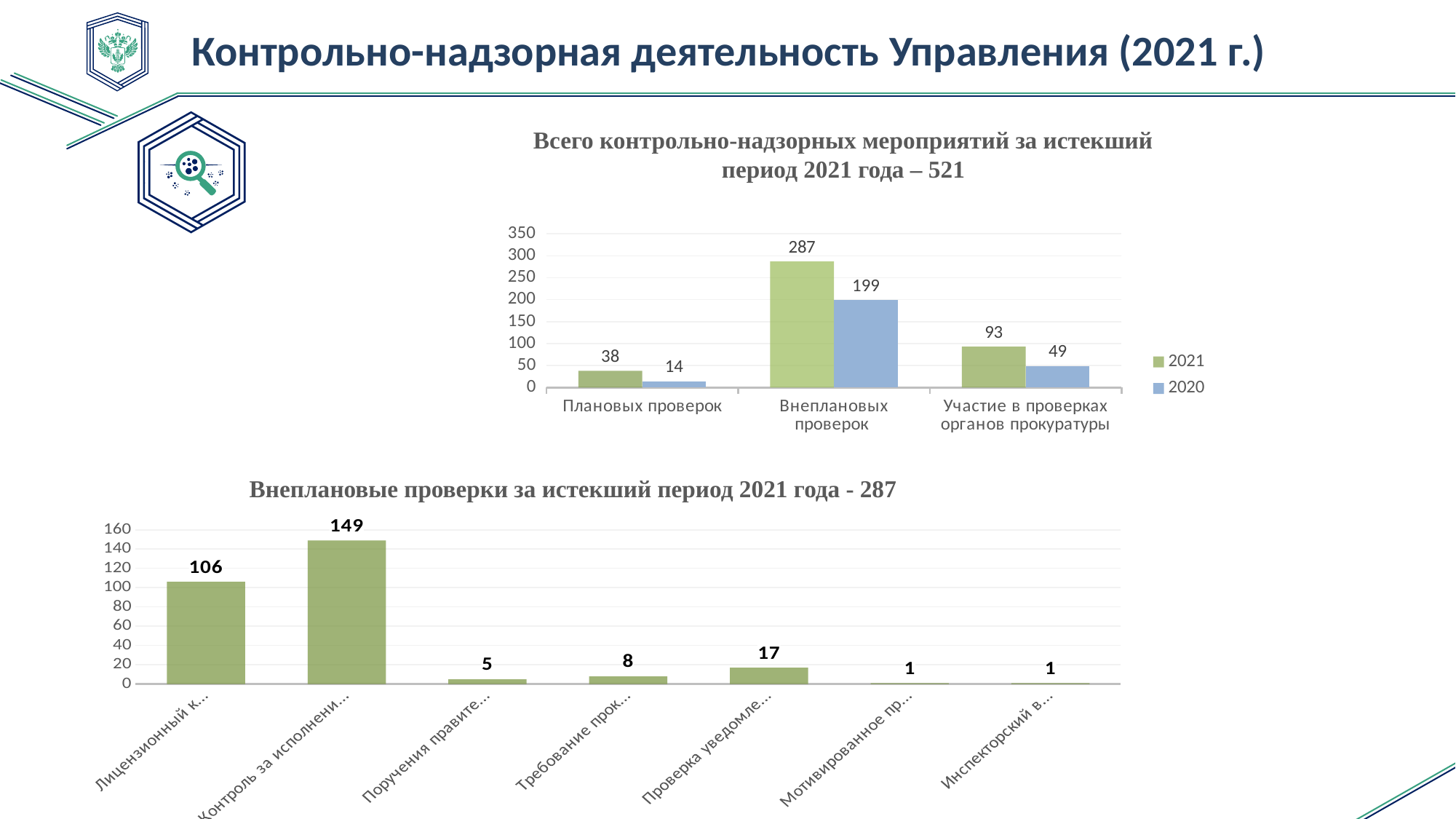
In the bottom chart (Внеплановые проверки за истекший период 2021 года), how many categories are plotted? 7 What kind of chart is the bottom chart (Внеплановые проверки за истекший период 2021 года)? Bar chart In the top chart (Всего контрольно-надзорных мероприятий), what is the 2021 value for Внеплановых проверок? 287 In the top chart (Всего контрольно-надзорных мероприятий), what is the 2020 value for Участие в проверках органов прокуратуры? 49 In the top chart (Всего контрольно-надзорных мероприятий), which category has the lowest 2020 value? Плановых проверок In the top chart (Всего контрольно-надзорных мероприятий), what is the 2020 value for Плановых проверок? 14 In the bottom chart (Внеплановые проверки за истекший период 2021 года), what is the difference between the bars labelled 'Контроль за исполнени...' and 'Лицензионный к...'? 43 In the top chart (Всего контрольно-надзорных мероприятий), which is larger: the 2021 value for Плановых проверок or the 2020 value for Участие в проверках органов прокуратуры? 2020 value for Участие в проверках органов прокуратуры In the top chart (Всего контрольно-надзорных мероприятий), how many series does the legend list? 2 In the top chart (Всего контрольно-надзорных мероприятий), what is the difference between the 2021 and 2020 values for Внеплановых проверок? 88 In the bottom chart (Внеплановые проверки за истекший период 2021 года), what is the value of the bar labelled 'Проверка уведомле...'? 17 In the bottom chart (Внеплановые проверки за истекший период 2021 года), what is the value of the bar labelled 'Контроль за исполнени...'? 149